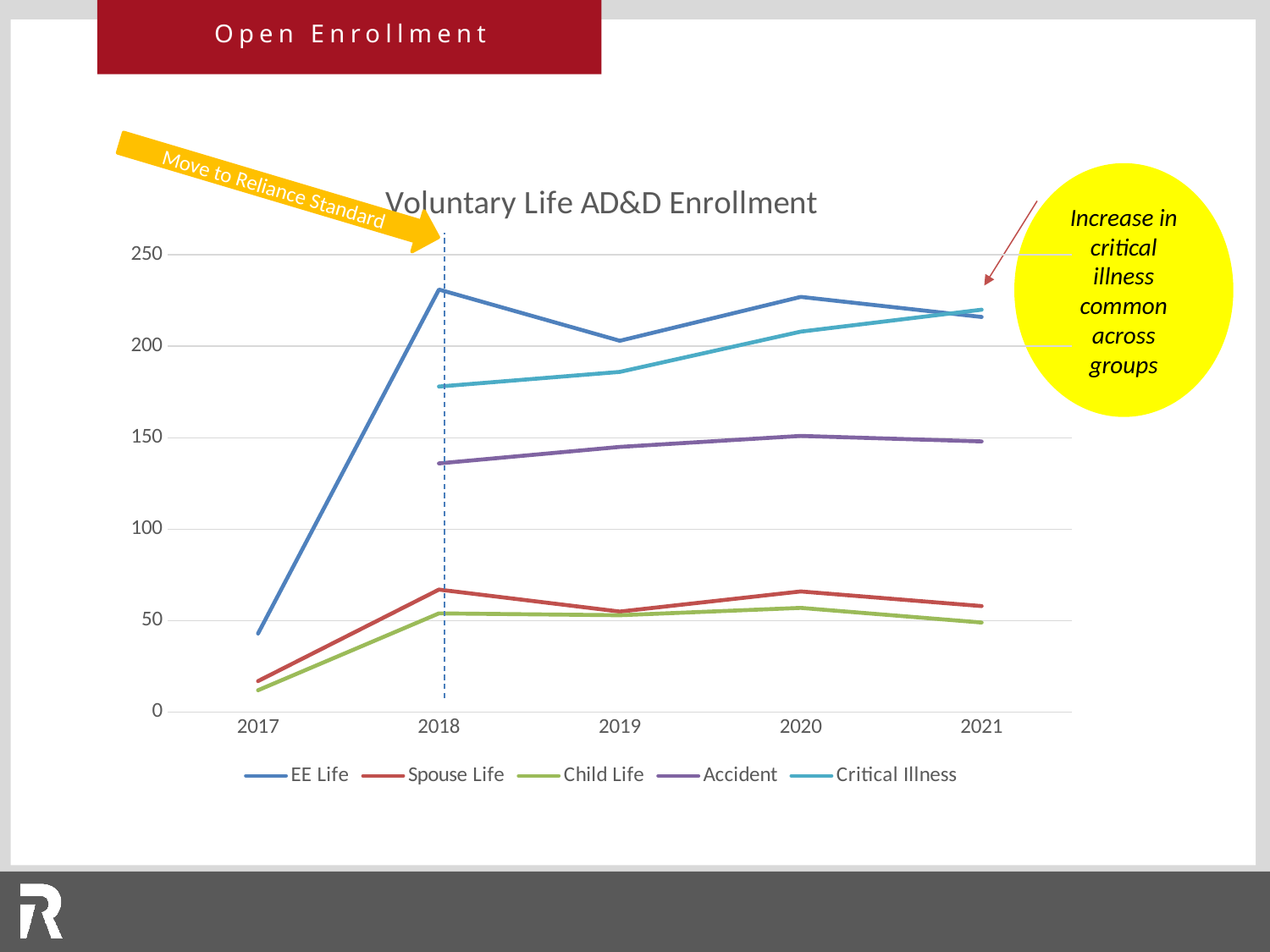
What kind of chart is shown on the slide? line chart Which series has the lowest value in 2021? Child Life In 2020, which is larger: Accident or Critical Illness? Critical Illness Is the value for EE Life in 2017 greater or less than 50? less Is the value for Accident in 2018 greater or less than 150? less Is the value for Critical Illness in 2018 greater or less than 200? less How many years are shown on the x axis? 5 Does the Critical Illness line rise or fall from 2018 to 2021? rise What is the title of the chart? Voluntary Life AD&D Enrollment How many series does the legend list? 5 Which series has the highest value in 2018? EE Life